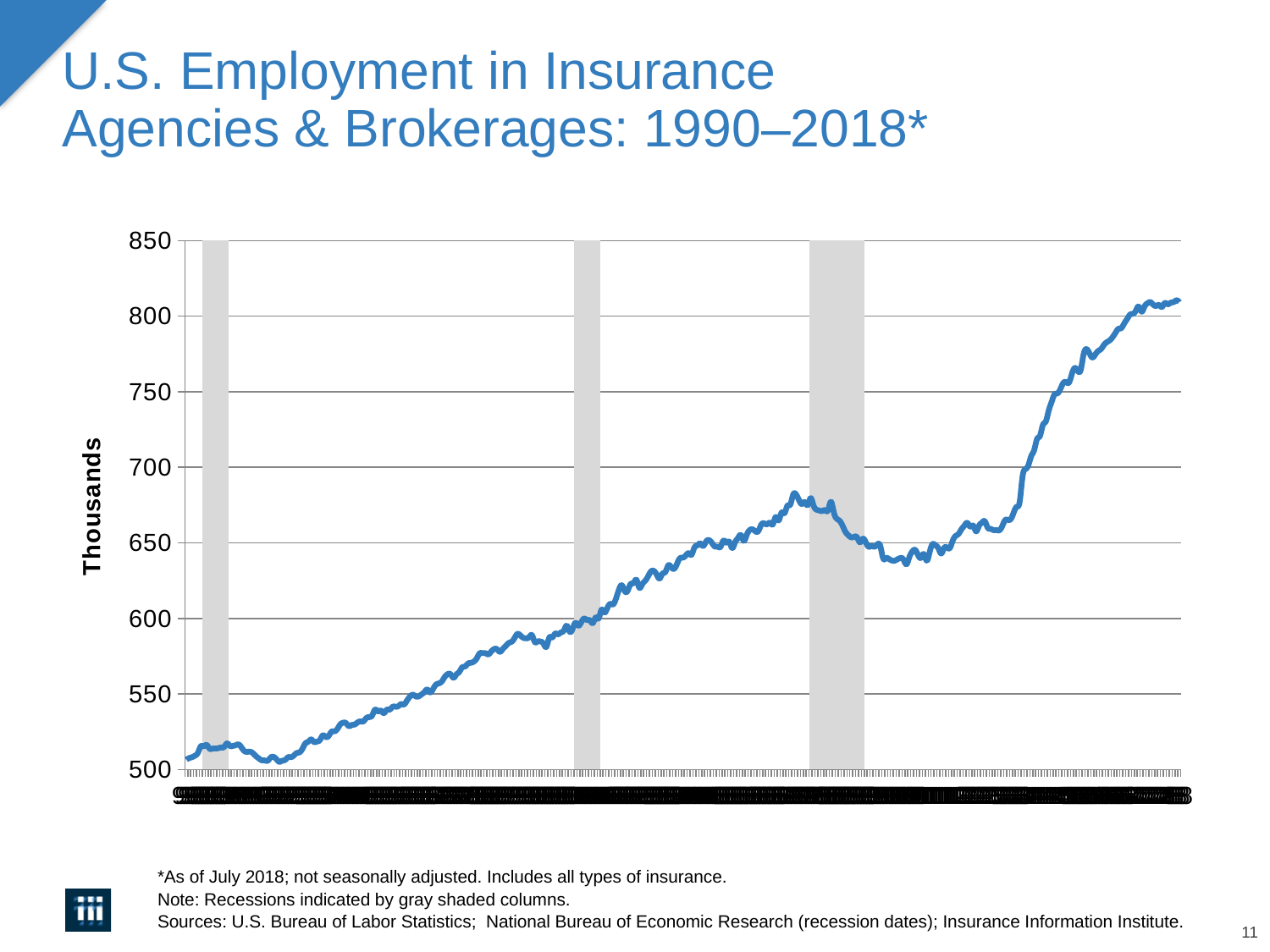
How many gray shaded recession columns are shown on the chart? 3 Is the low point reached after the third gray shaded recession column greater or less than 600? greater Is the value at the right-hand end of the line greater or less than the value at the left-hand start? greater Is the value at the left-hand start of the line (1990) greater or less than 550? less Is the lowest point of the line, near the left of the chart, greater or less than 550? less What kind of chart is shown on the slide? line chart Overall, do the values rise or fall from the left of the x axis to the right? rise What is the label on the vertical axis of the chart? Thousands